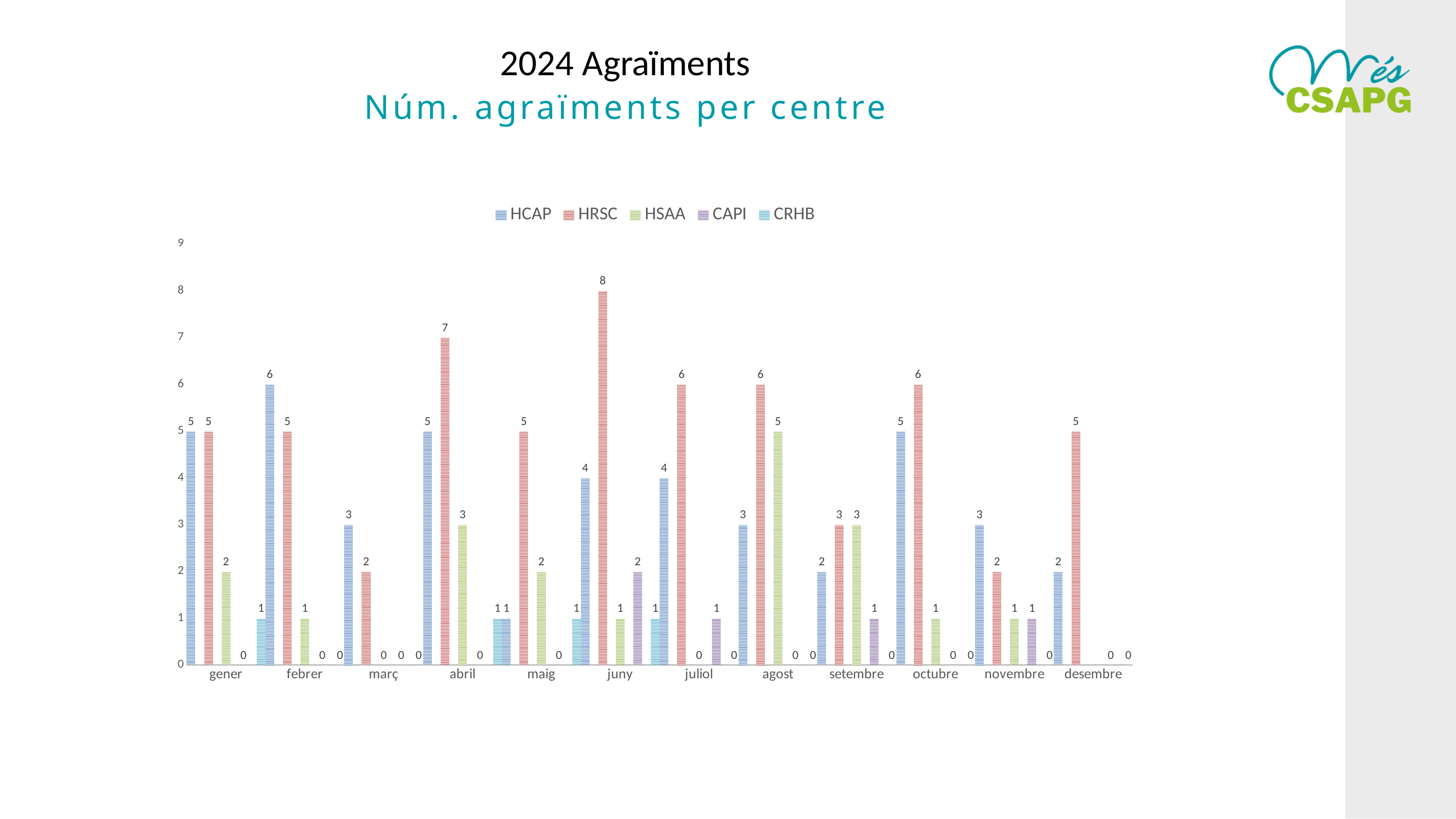
What is the value for HSAA in agost? 5 What is the value for CAPI in juny? 2 In which month does HCAP have its lowest value? maig What is the subtitle of the chart shown in teal? Núm. agraïments per centre How many series does the legend list? 5 What is the value for HCAP in febrer? 6 What is the value for HRSC in juny? 8 What is the difference between HRSC and HCAP in abril? 2 In which month does HRSC reach its highest value? juny How many months are shown on the x axis? 12 What type of chart is shown on the slide? bar chart Which is larger in novembre, HCAP or HRSC? HCAP